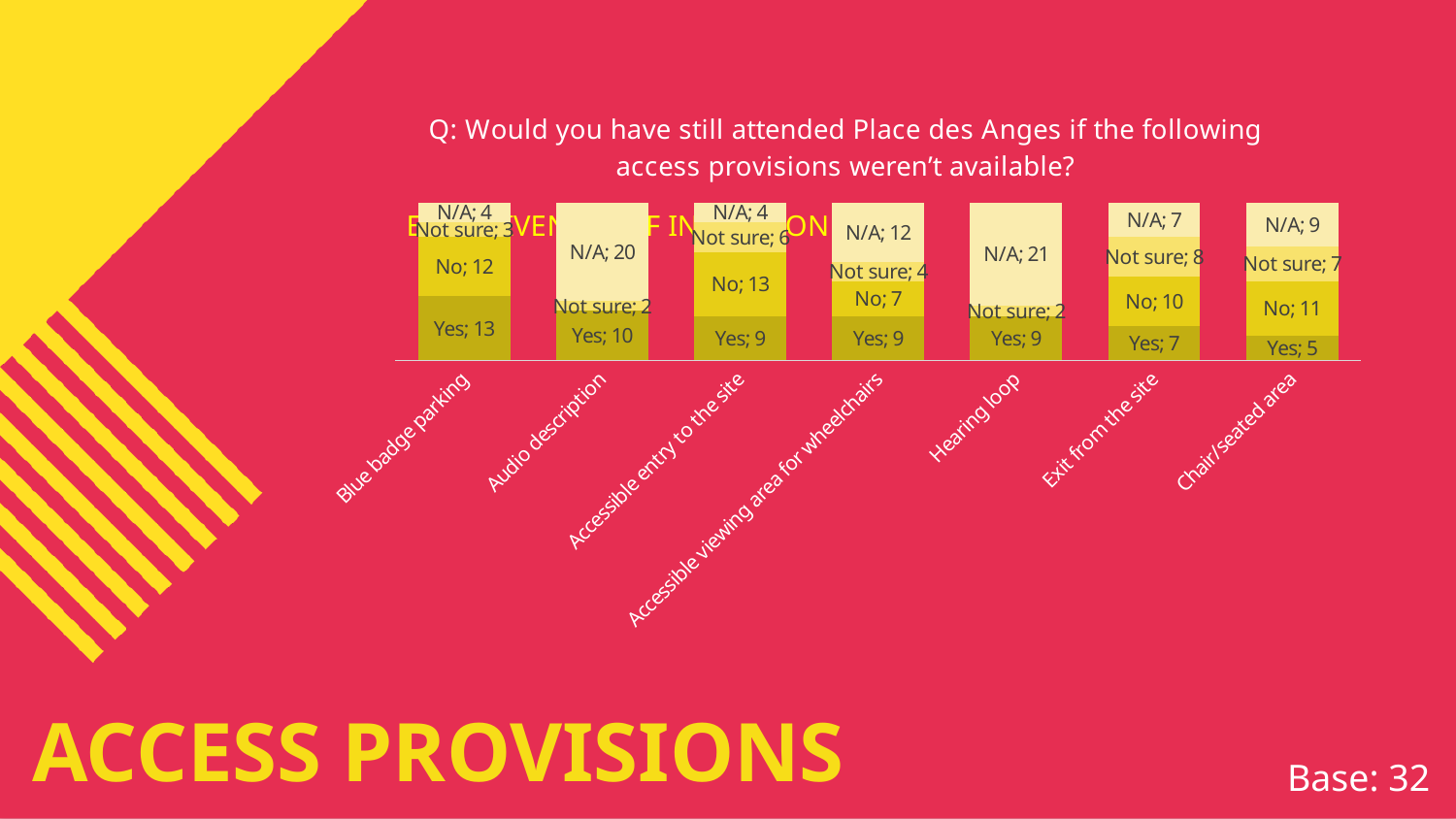
How many access provisions are shown on the x axis? 7 What kind of chart is shown on the slide? Stacked bar chart Which access provision has the highest 'Yes' value? Blue badge parking Which has a larger 'No' value: Accessible entry to the site or Chair/seated area? Accessible entry to the site What is the 'Not sure' value for Chair/seated area? 7 What is the total of the stacked bar for Exit from the site? 32 What is the difference between the 'Yes' value for Blue badge parking and the 'Yes' value for Chair/seated area? 8 Which access provision has the lowest 'Yes' value? Chair/seated area What is the 'No' value for Exit from the site? 10 What is the 'N/A' value for Hearing loop? 21 What is the 'Yes' value for Blue badge parking? 13 What question does the chart title say respondents were asked? Would you have still attended Place des Anges if the following access provisions weren't available?